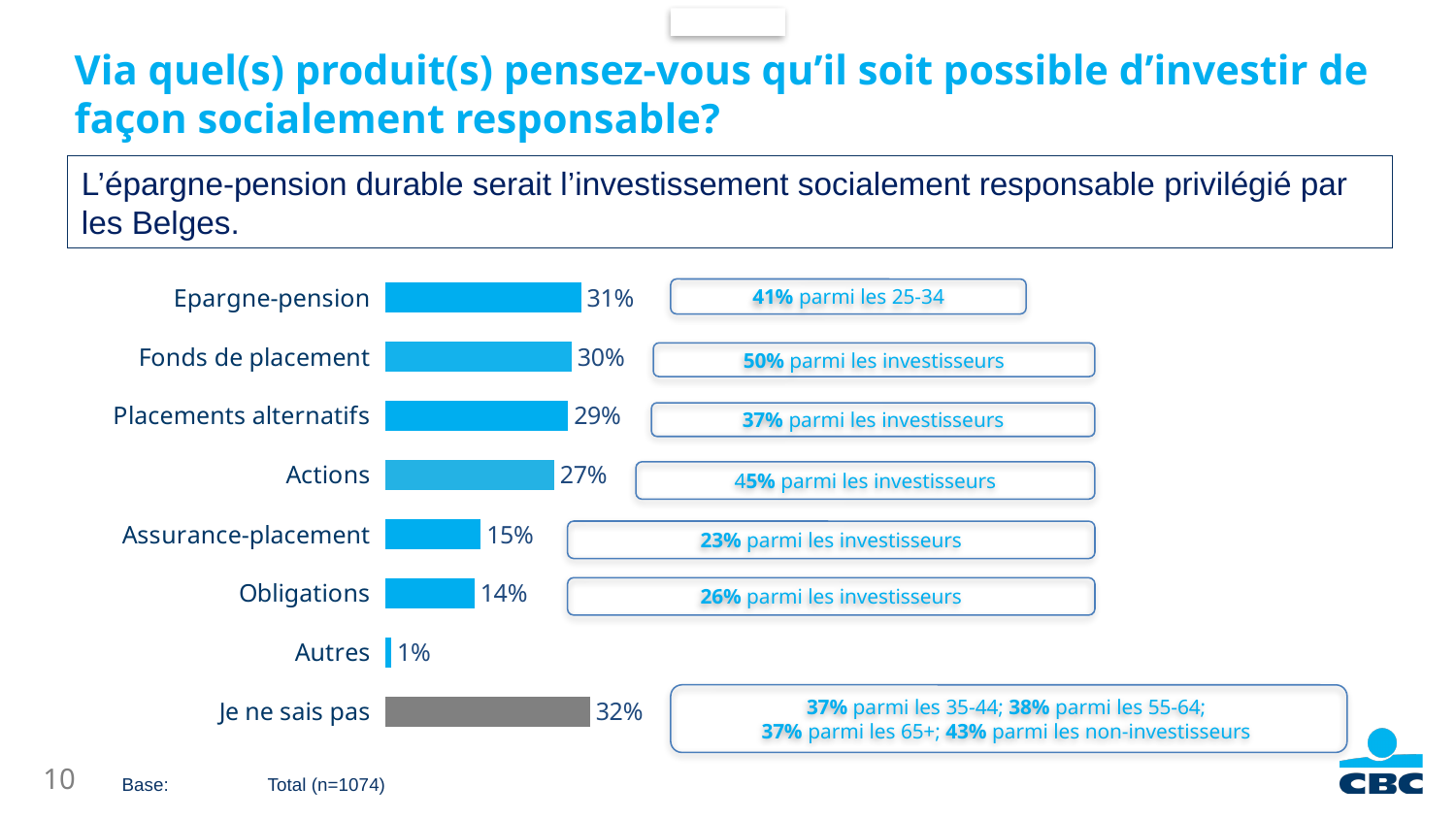
What is the value for Placements alternatifs? 29% Which category has the lowest value? Autres How many categories are shown in the chart? 8 What is the value for Je ne sais pas? 32% What is the value for Epargne-pension? 31% What is the difference between the values for Fonds de placement and Actions? 3% What kind of chart is shown on the slide? bar chart Which is larger, the value for Actions or the value for Assurance-placement? Actions What is the difference between the values for Epargne-pension and Obligations? 17% Which category has the highest value? Je ne sais pas Which bar is shown in a different colour (grey) from the others? Je ne sais pas What is the value for Assurance-placement? 15%